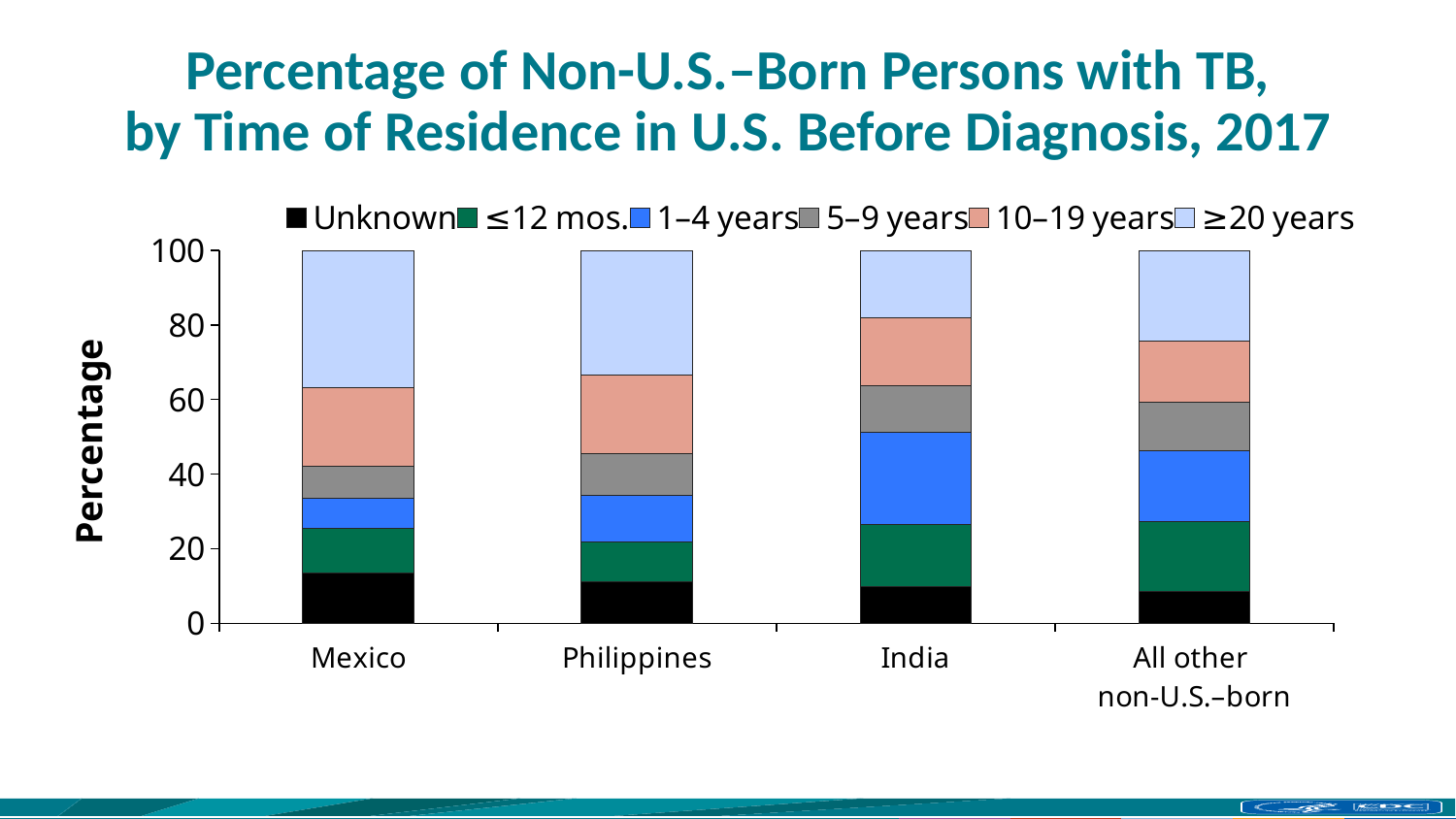
Which legend entry is shown in black? Unknown What kind of chart is shown on the slide? Stacked bar chart Is the 1–4 years segment larger for India or for Mexico? India Which category has the largest 1–4 years segment? India How many series does the legend list? 6 What is the total height of the Mexico bar? 100 What is the label on the y axis? Percentage In the Philippines bar, is the top of the 10–19 years segment greater or less than 60? greater Is the Unknown value for Mexico greater or less than 20? less Which category has the smallest ≥20 years segment? India Is the ≥20 years segment larger for Mexico or for India? Mexico How many country/origin categories are shown on the x axis? 4